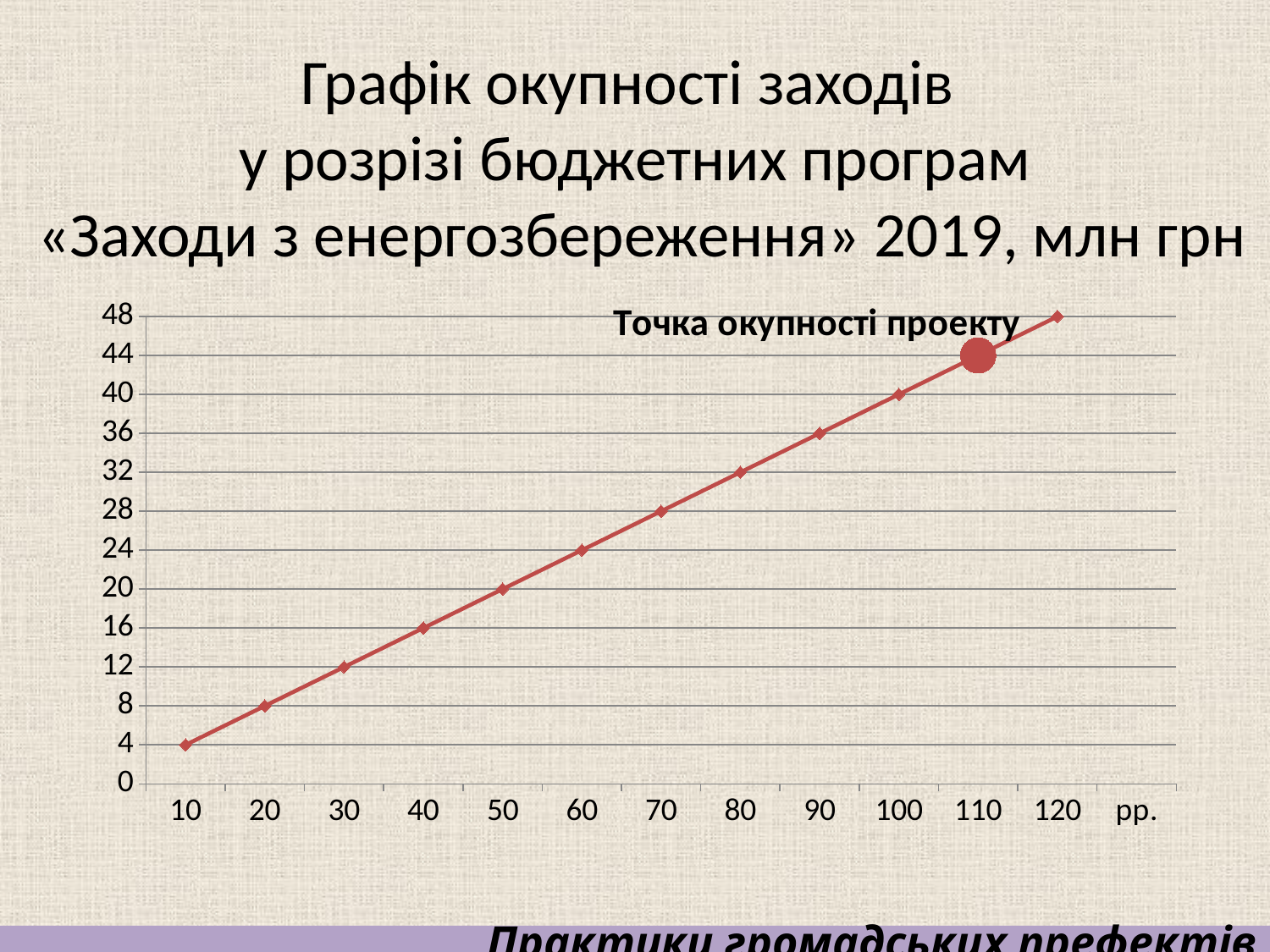
What is the value at x = 10 on the chart? 4 Do the values rise or fall as x increases along the x axis? rise What is the difference between the values at x = 120 and x = 10? 44 What kind of chart is shown on the slide? line chart What label is written next to the large circle marker on the chart? Точка окупності проекту At which x value is the plotted value highest? 120 What is the value at x = 120 on the chart? 48 Which is larger, the value at x = 50 or the value at x = 80? x = 80 What is the value at x = 60 on the chart? 24 How many data points are plotted on the line? 12 At which x value is the plotted value lowest? 10 What is the value at x = 100 on the chart? 40